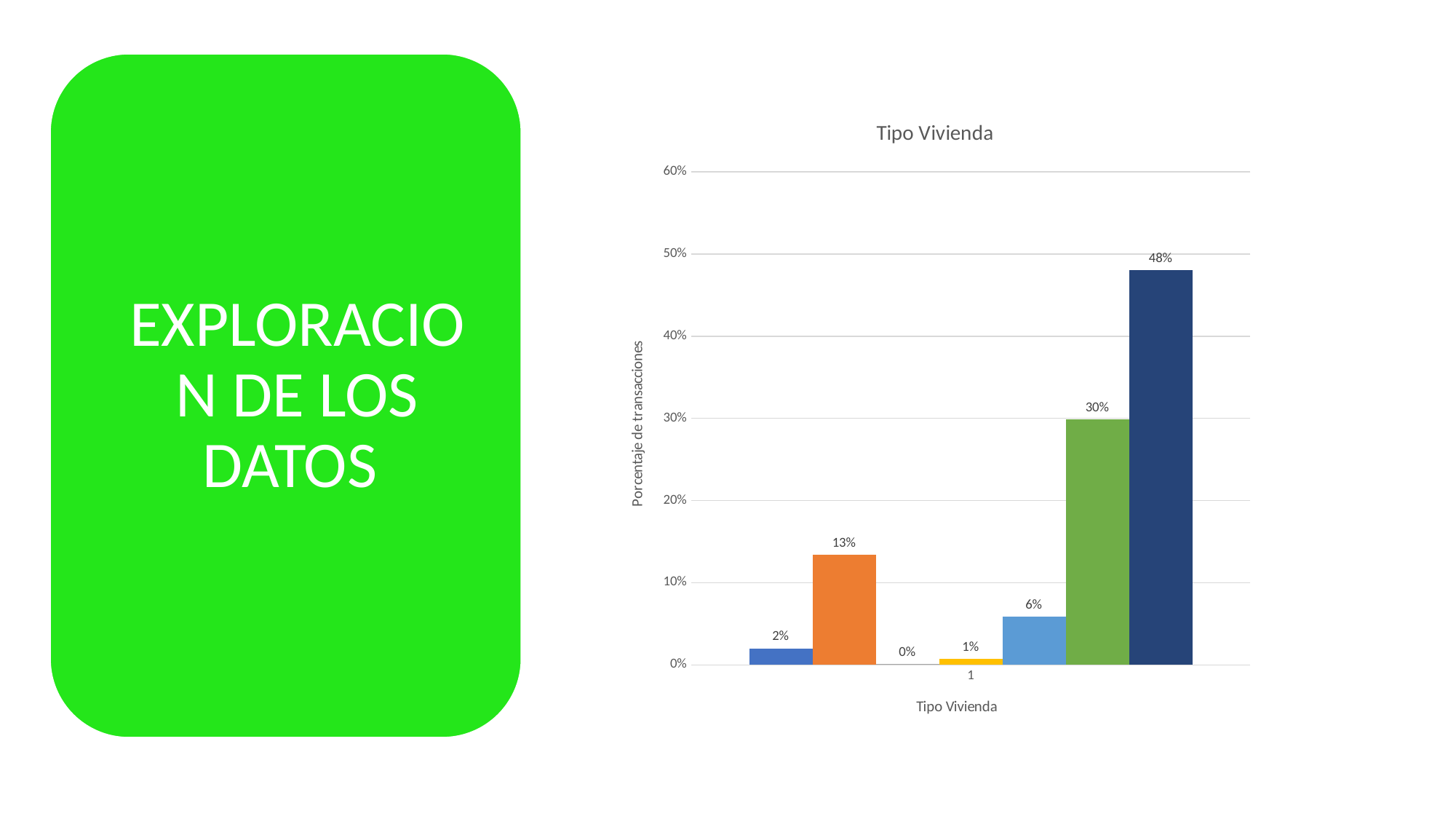
What is the difference between the dark blue bar (48%) and the green bar (30%)? 18% What value is shown for the light blue bar? 6% What is the title of the chart? Tipo Vivienda What value is shown for the orange bar? 13% What is the highest value shown in the chart? 48% How many bars are plotted in the chart? 7 Is the value for the dark blue bar greater or less than 40%? greater What is the lowest value shown in the chart? 0% What is the label on the vertical axis of the chart? Porcentaje de transacciones What kind of chart is shown on the slide? bar chart Which is larger, the orange bar or the light blue bar? the orange bar What value is shown for the green bar? 30%